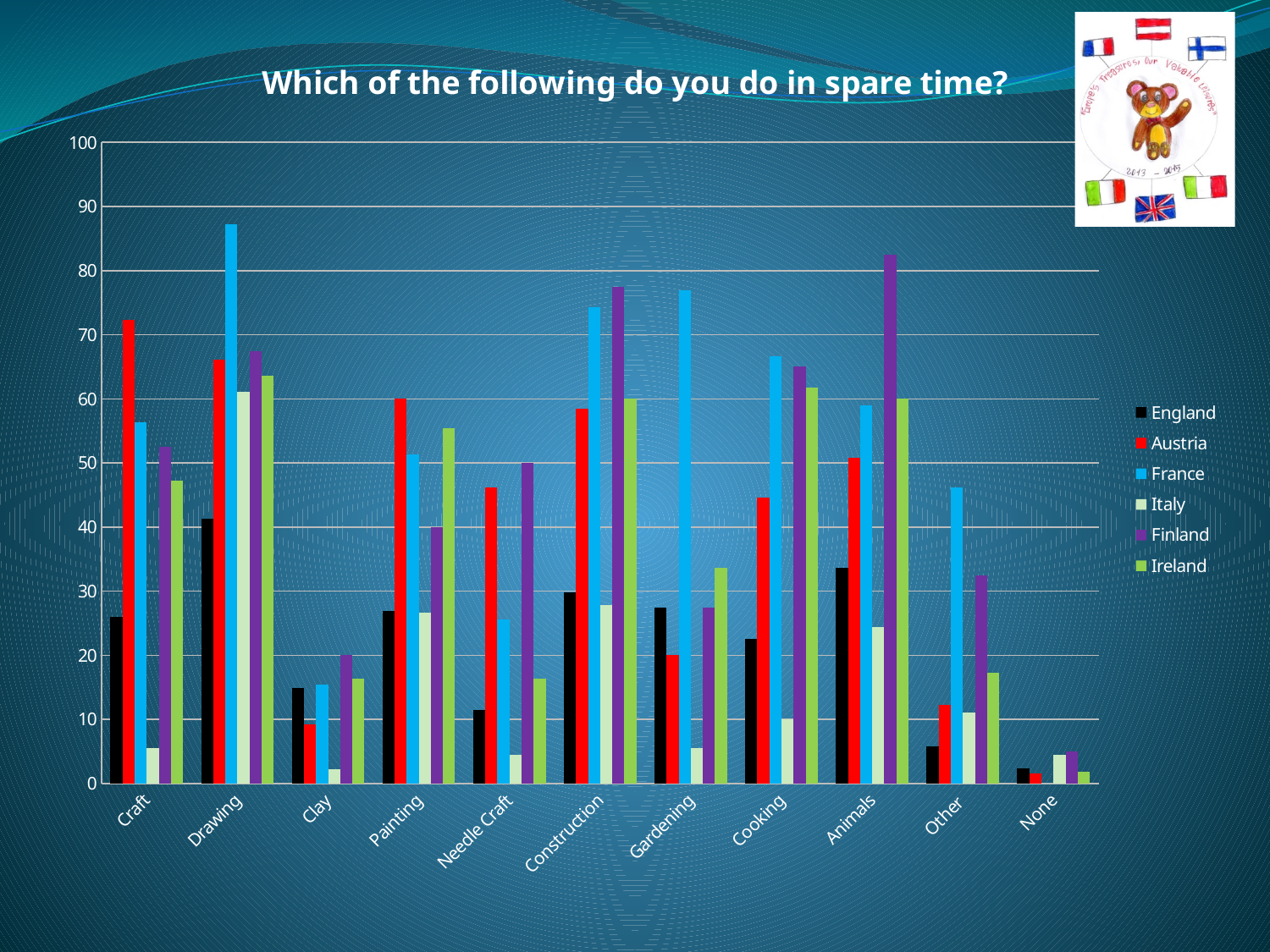
Is the value for France in the Drawing category greater or less than 80? greater Which country has the lowest value in the Drawing category? England What is the title of the chart? Which of the following do you do in spare time? In which category does France have its highest value? Drawing How many activity categories are shown on the x axis? 11 How many series does the legend list? 6 In the Gardening category, which is larger: the value for France or the value for Ireland? France Which country has the highest value in the Craft category? Austria Is the value for Italy in the Clay category greater or less than 10? less Is the value for Finland in the Animals category greater or less than 70? greater In the Craft category, which is larger: the value for Austria or the value for France? Austria What kind of chart is shown on the slide? bar chart